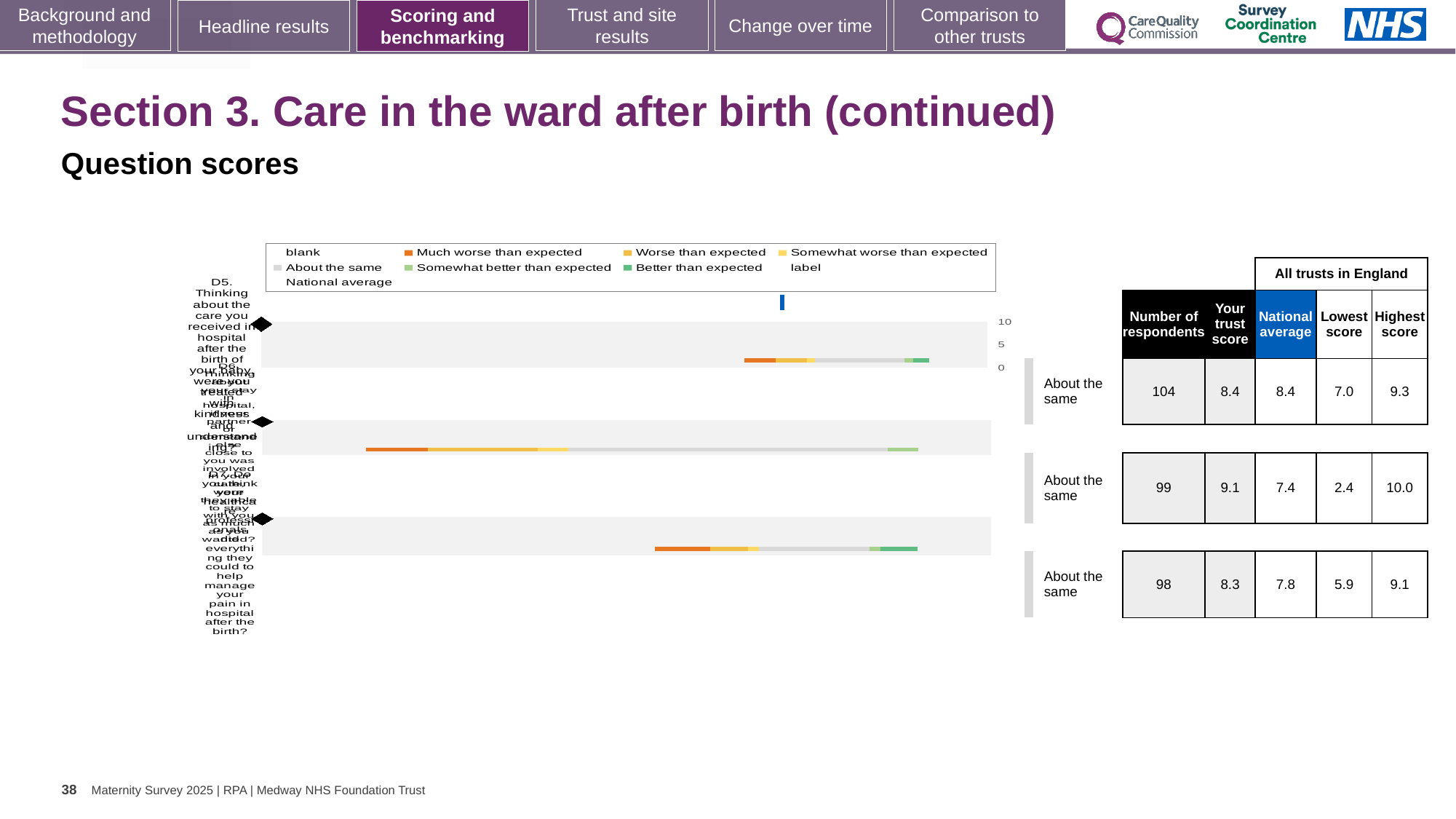
What is the highest tick value shown on the chart's numeric axis? 10 How many horizontal bars are plotted in the chart? 3 What benchmark label is shown beside each of the three bars in the chart? About the same What kind of chart is shown on the slide? bar chart What colour does the legend use for 'Much worse than expected'? orange